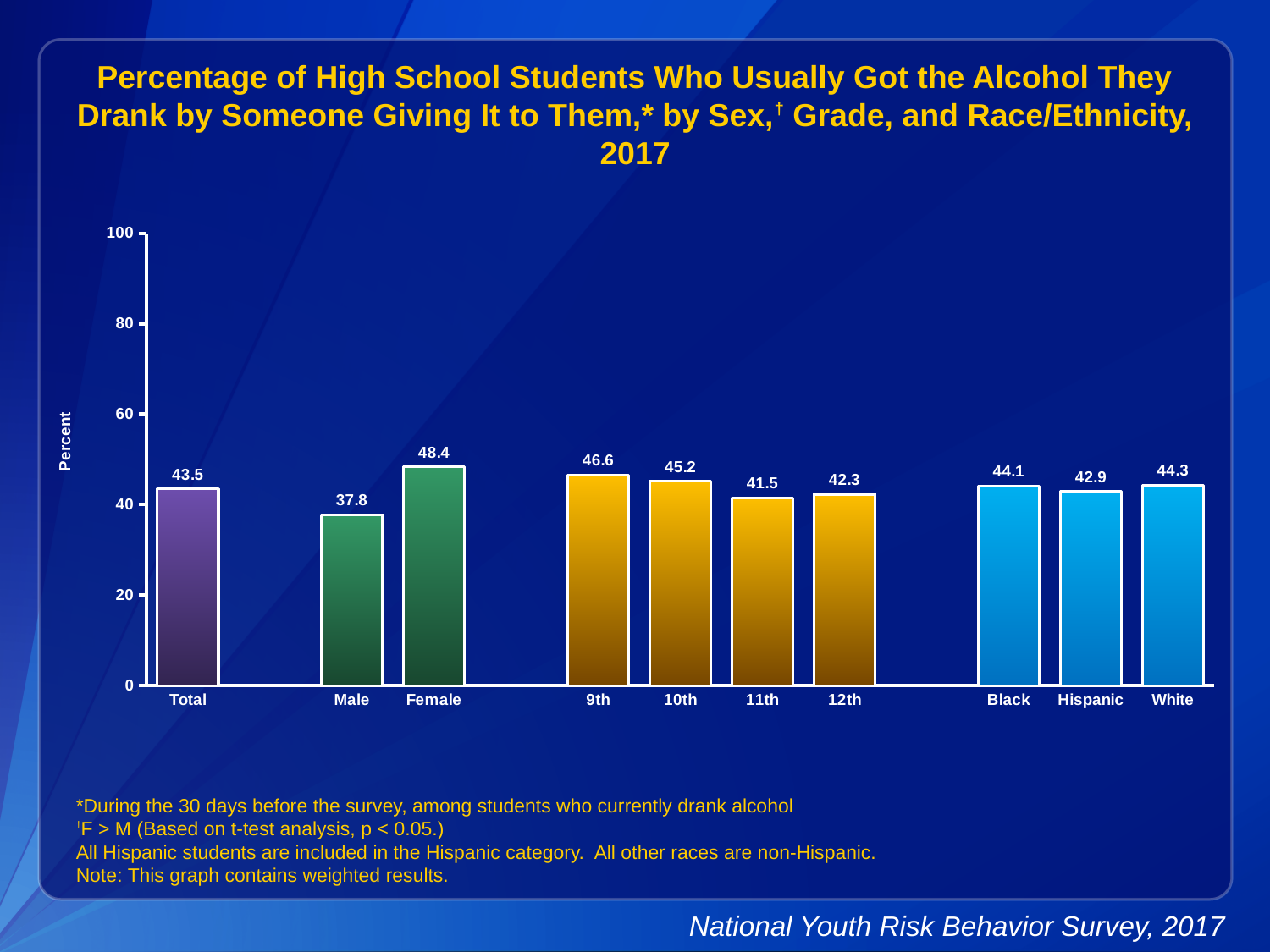
Is the value for Total greater or less than 40? greater What is the difference between the Female and Male values? 10.6 What is the value for Hispanic students? 42.9 Which is larger, the value for 9th grade or the value for 10th grade? 9th What is the difference between the 9th grade and 12th grade values? 4.3 Which category has the lowest value? Male How many bars are shown in the chart? 10 Which category has the highest value? Female What is the value for 11th grade? 41.5 What kind of chart is shown on the slide? bar chart What is the value for Male? 37.8 What is the value for Female? 48.4